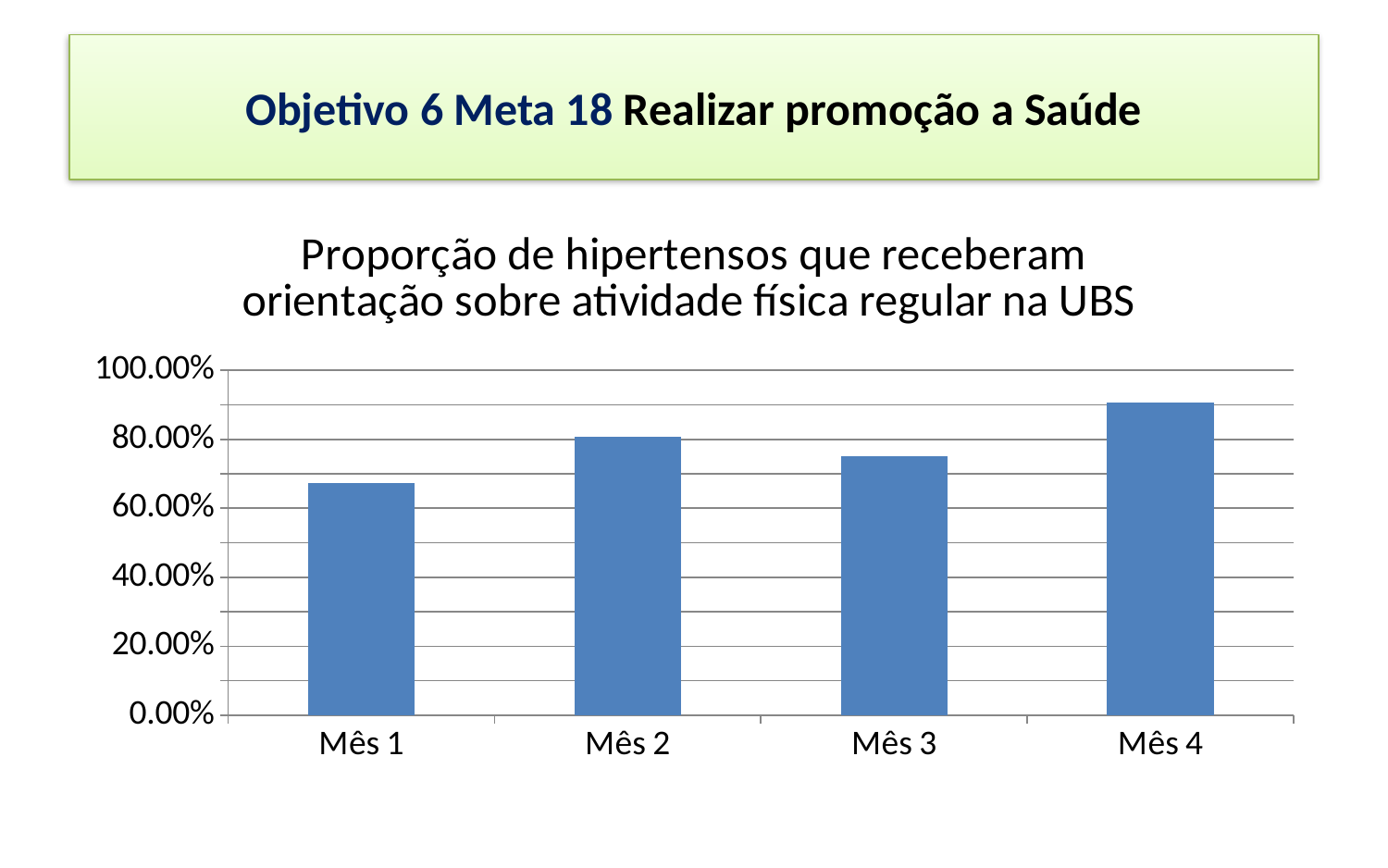
Does the value rise or fall from Mês 3 to Mês 4? Rise Which month has the highest proportion of hypertensive patients who received guidance on regular physical activity? Mês 4 How many months (categories) are shown on the x axis of the chart? 4 Which is larger, the value for Mês 2 or the value for Mês 3? Mês 2 Is the value for Mês 1 greater or less than 80.00%? less What kind of chart is shown on the slide? Bar chart Is the value for Mês 4 greater or less than 80.00%? greater Which month has the lowest proportion in the chart? Mês 1 Is the value for Mês 3 greater or less than 80.00%? less What is the title of the chart? Proporção de hipertensos que receberam orientação sobre atividade física regular na UBS